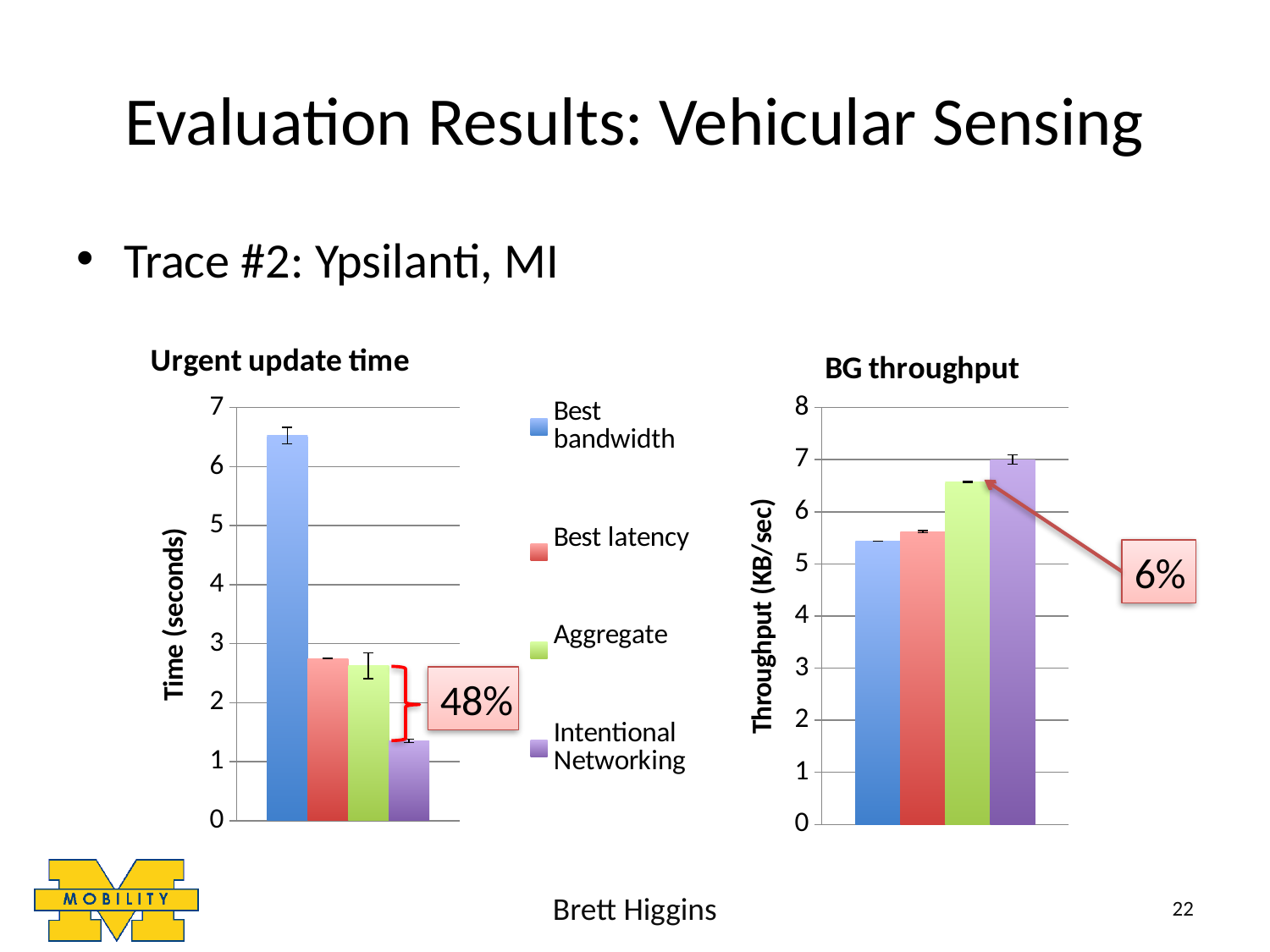
In the BG throughput chart, is the value for Aggregate greater or less than 6? greater In the Urgent update time chart, what is the label of the y axis? Time (seconds) In the Urgent update time chart, what kind of chart is shown? bar chart In the Urgent update time chart, which series has the lowest time? Intentional Networking In the BG throughput chart, which series has the lowest throughput? Best bandwidth In the Urgent update time chart, how many series does the legend list? 4 In the Urgent update time chart, which series has the highest time? Best bandwidth In the BG throughput chart, which is larger, the value for Aggregate or the value for Best latency? Aggregate In the Urgent update time chart, is the value for Best bandwidth greater or less than 6? greater In the BG throughput chart, what percentage is shown in the callout pointing at the Aggregate bar? 6% In the BG throughput chart, which series has the highest throughput? Intentional Networking In the Urgent update time chart, is the value for Intentional Networking greater or less than 2? less